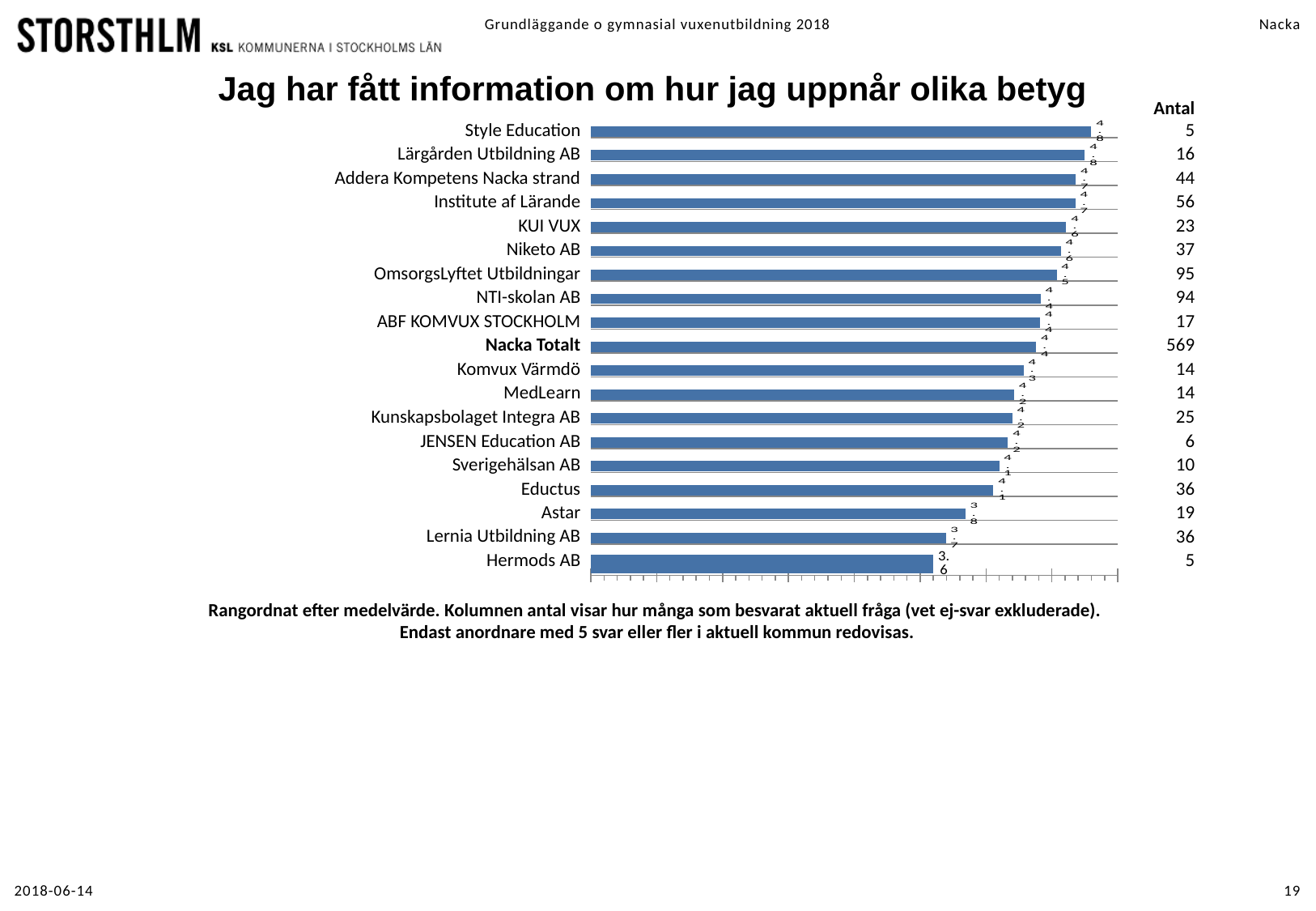
What is the difference between the values for Style Education and Hermods AB? 1.2 Do the bar values increase or decrease going from the top of the chart to the bottom? decrease Which provider has the lowest value in the chart? Hermods AB What is the value shown for Astar? 3.8 What is the title of the chart? Jag har fått information om hur jag uppnår olika betyg What is the value shown for Hermods AB? 3.6 How many providers (categories) are listed in the chart? 19 What is the value shown for KUI VUX? 4.6 Which has the larger value, Style Education or Hermods AB? Style Education What is the value shown for Nacka Totalt? 4.4 What kind of chart is shown on the slide? bar chart What is the value shown for Eductus? 4.1